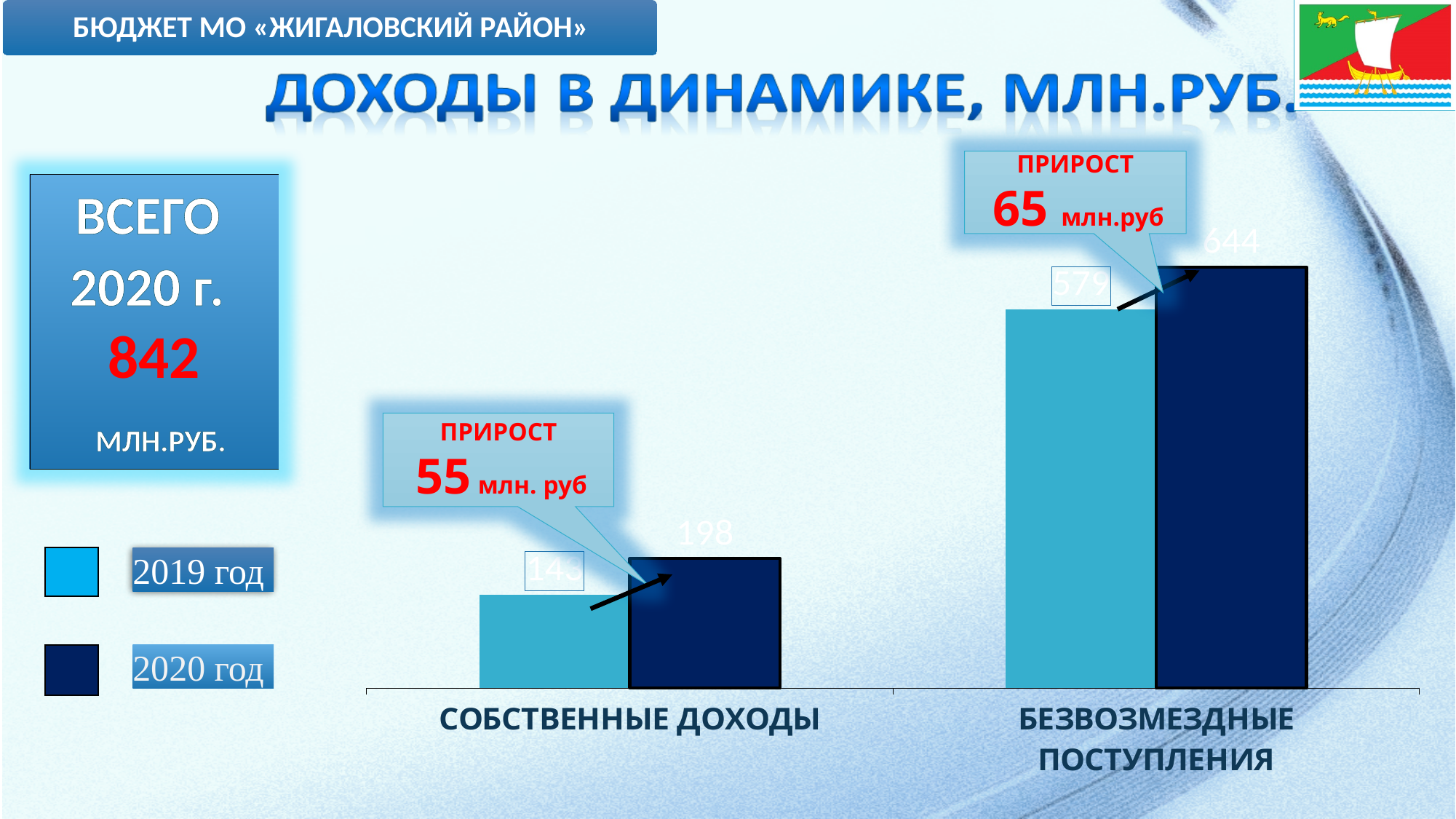
Which category has the lowest value for 2019 год? СОБСТВЕННЫЕ ДОХОДЫ What is the title of the chart? ДОХОДЫ В ДИНАМИКЕ, МЛН.РУБ. How many categories are shown on the x axis of the chart? 2 What is the value for 2019 год in the category БЕЗВОЗМЕЗДНЫЕ ПОСТУПЛЕНИЯ? 579 Which is larger for БЕЗВОЗМЕЗДНЫЕ ПОСТУПЛЕНИЯ: the 2019 год value or the 2020 год value? 2020 год What type of chart is shown on the slide? bar chart What is the value for 2019 год in the category СОБСТВЕННЫЕ ДОХОДЫ? 143 Which category has the highest value for 2020 год? БЕЗВОЗМЕЗДНЫЕ ПОСТУПЛЕНИЯ What is the value for 2020 год in the category БЕЗВОЗМЕЗДНЫЕ ПОСТУПЛЕНИЯ? 644 What is the value for 2020 год in the category СОБСТВЕННЫЕ ДОХОДЫ? 198 What is the difference between the 2020 год and 2019 год values for СОБСТВЕННЫЕ ДОХОДЫ? 55 How many series does the legend list? 2